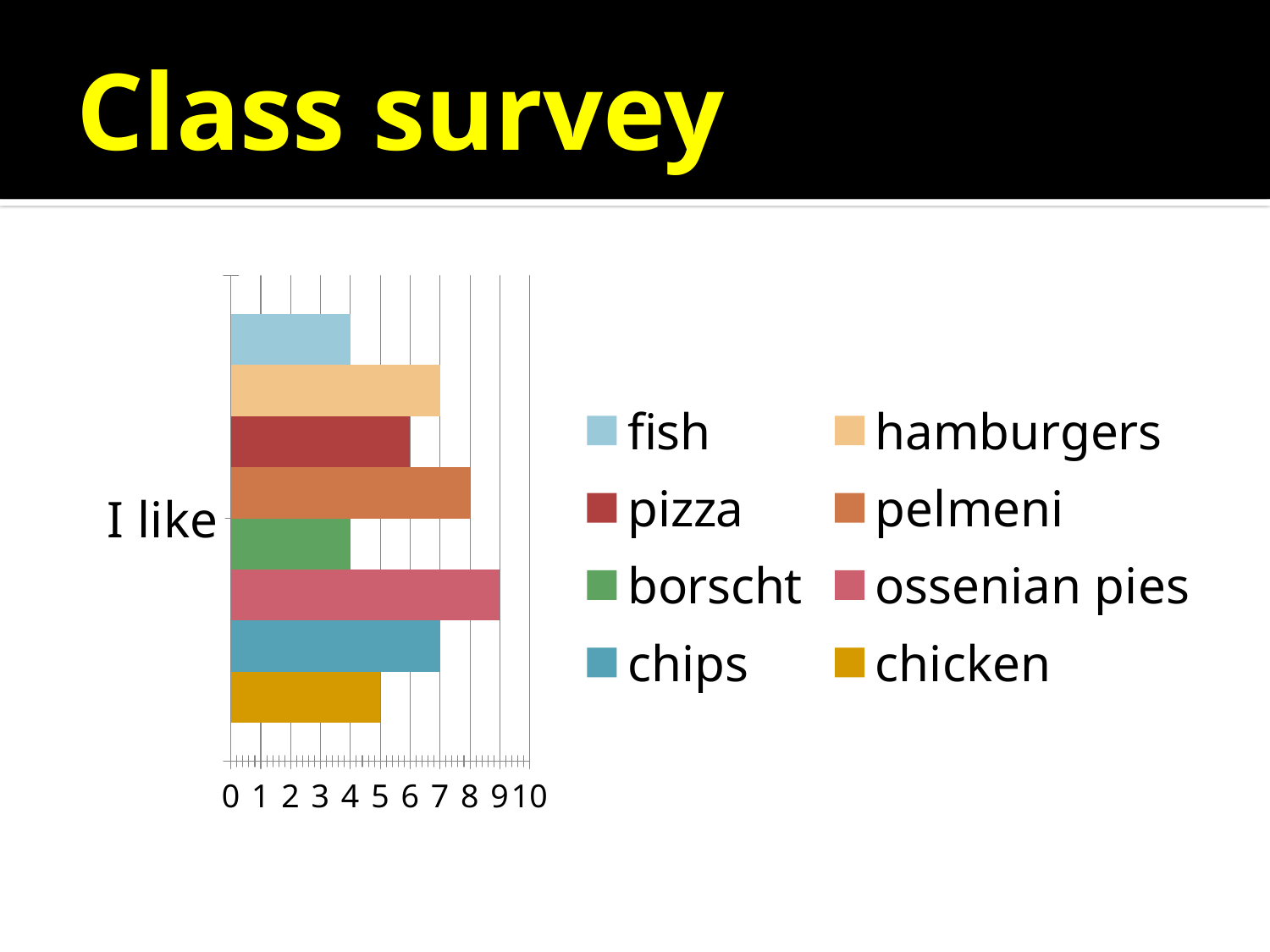
What kind of chart is shown on the slide? bar chart What is the value for ossenian pies? 9 What is the value for pizza? 6 Is the value for hamburgers greater or less than 5? greater What is the value for pelmeni? 8 What is the difference between the values for ossenian pies and chicken? 4 Which is larger, the value for pelmeni or the value for borscht? pelmeni What is the category label shown on the vertical axis? I like Which food has the longest bar? ossenian pies What is the value for chicken? 5 How many series does the legend list? 8 Is the value for fish greater or less than 5? less